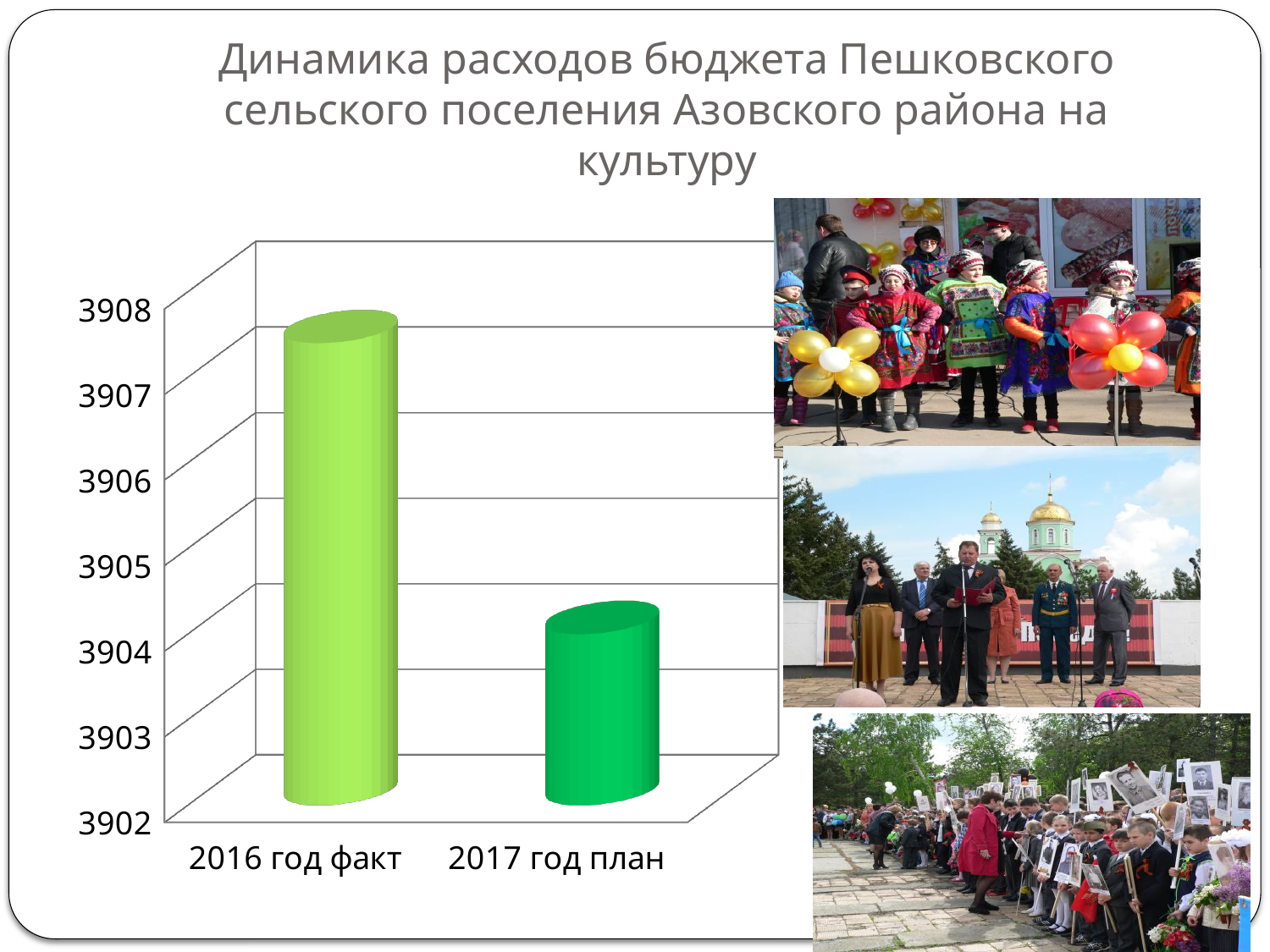
What is the lowest value shown on the vertical axis of the chart? 3902 Which category has the lowest value on the chart? 2017 год план How many categories are plotted on the chart? 2 What kind of chart is shown on the slide? bar chart Do the values rise or fall from 2016 год факт to 2017 год план? fall Is the value for 2017 год план greater or less than 3905? less Is the value for 2016 год факт greater or less than 3906? greater What is the title of the slide containing the chart? Динамика расходов бюджета Пешковского сельского поселения Азовского района на культуру Is the value for 2017 год план greater or less than 3903? greater Which category has the highest value on the chart? 2016 год факт Which is larger, the value for 2016 год факт or the value for 2017 год план? 2016 год факт